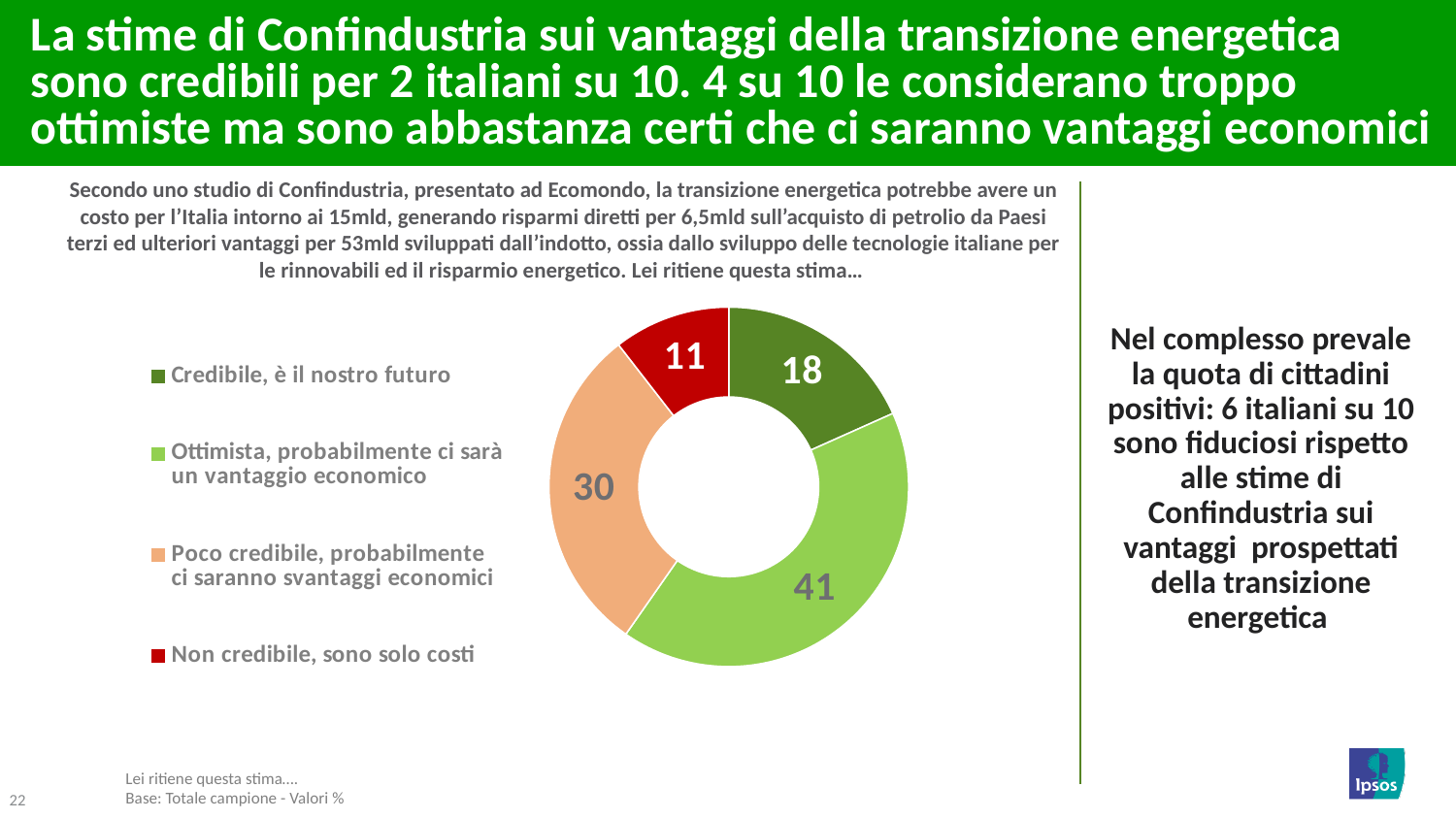
What value is shown for "Poco credibile, probabilmente ci saranno svantaggi economici"? 30 Which category has the smallest share of the chart? Non credibile, sono solo costi What kind of chart is shown on the slide? Doughnut chart What value is shown for "Non credibile, sono solo costi"? 11 How many categories does the chart show? 4 What value is shown for "Credibile, è il nostro futuro"? 18 Which is larger: the value for "Credibile, è il nostro futuro" or the value for "Non credibile, sono solo costi"? Credibile, è il nostro futuro Which category has the largest share of the chart? Ottimista, probabilmente ci sarà un vantaggio economico Which colour represents "Non credibile, sono solo costi" in the chart? Red What value is shown for "Ottimista, probabilmente ci sarà un vantaggio economico"? 41 What is the combined value of "Credibile, è il nostro futuro" and "Ottimista, probabilmente ci sarà un vantaggio economico"? 59 What is the difference between the values for "Ottimista, probabilmente ci sarà un vantaggio economico" and "Poco credibile, probabilmente ci saranno svantaggi economici"? 11